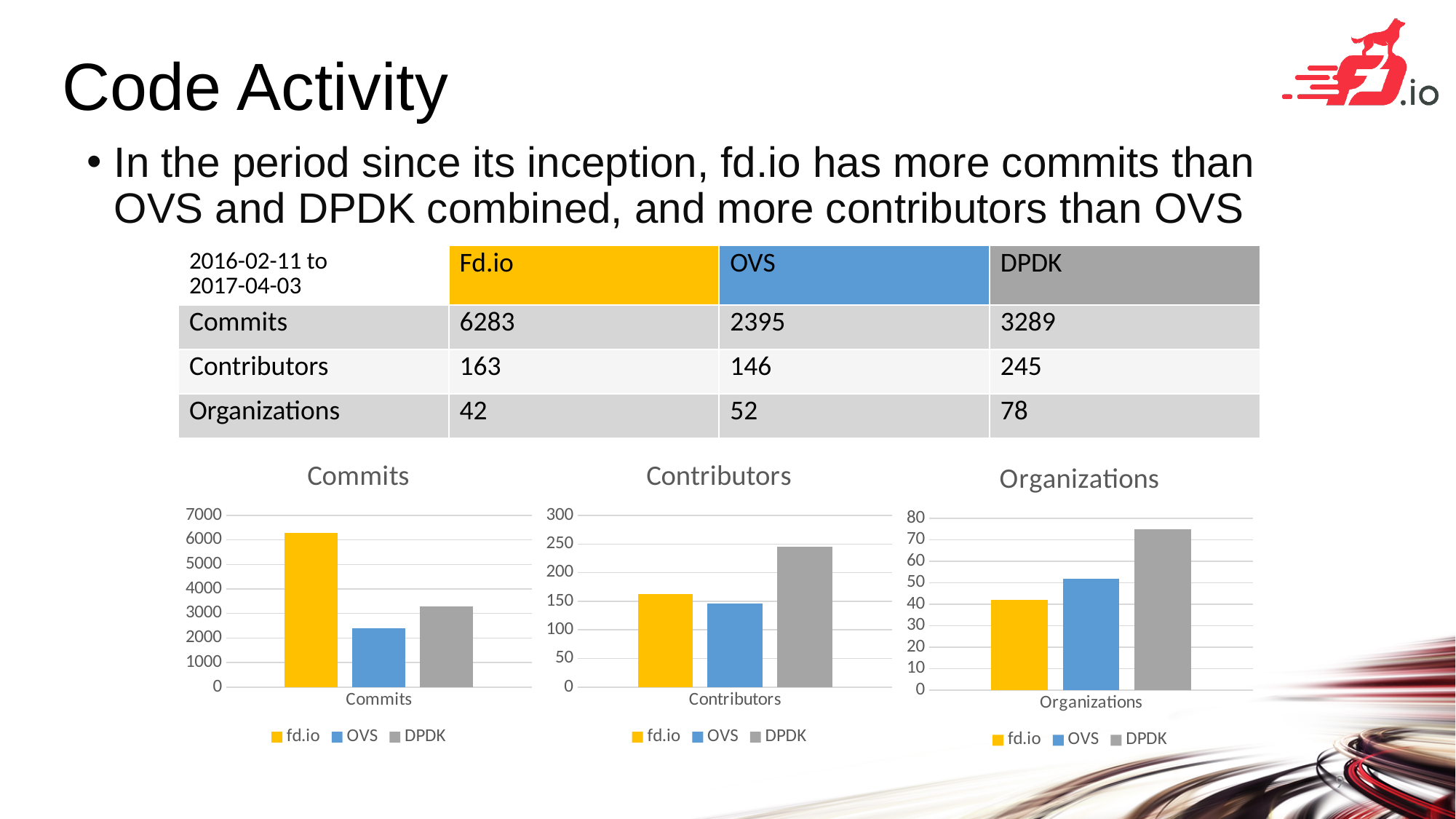
In the Contributors chart, which is larger, fd.io or OVS? fd.io In the Contributors chart, what is the value for DPDK? 245 In the Organizations chart, what is the value for OVS? 52 In the Organizations chart, which series has the highest value? DPDK In the Commits chart, is the value for OVS greater or less than 3000? less In the Commits chart, which series has the highest value? fd.io What kind of chart is the Contributors chart? bar chart In the Contributors chart, which series has the lowest value? OVS In the Organizations chart, what colour is the fd.io bar? yellow How many series does the legend of the Organizations chart list? 3 In the Commits chart, what is the value for fd.io? 6283 In the Commits chart, what is the difference between the fd.io and DPDK values? 2994